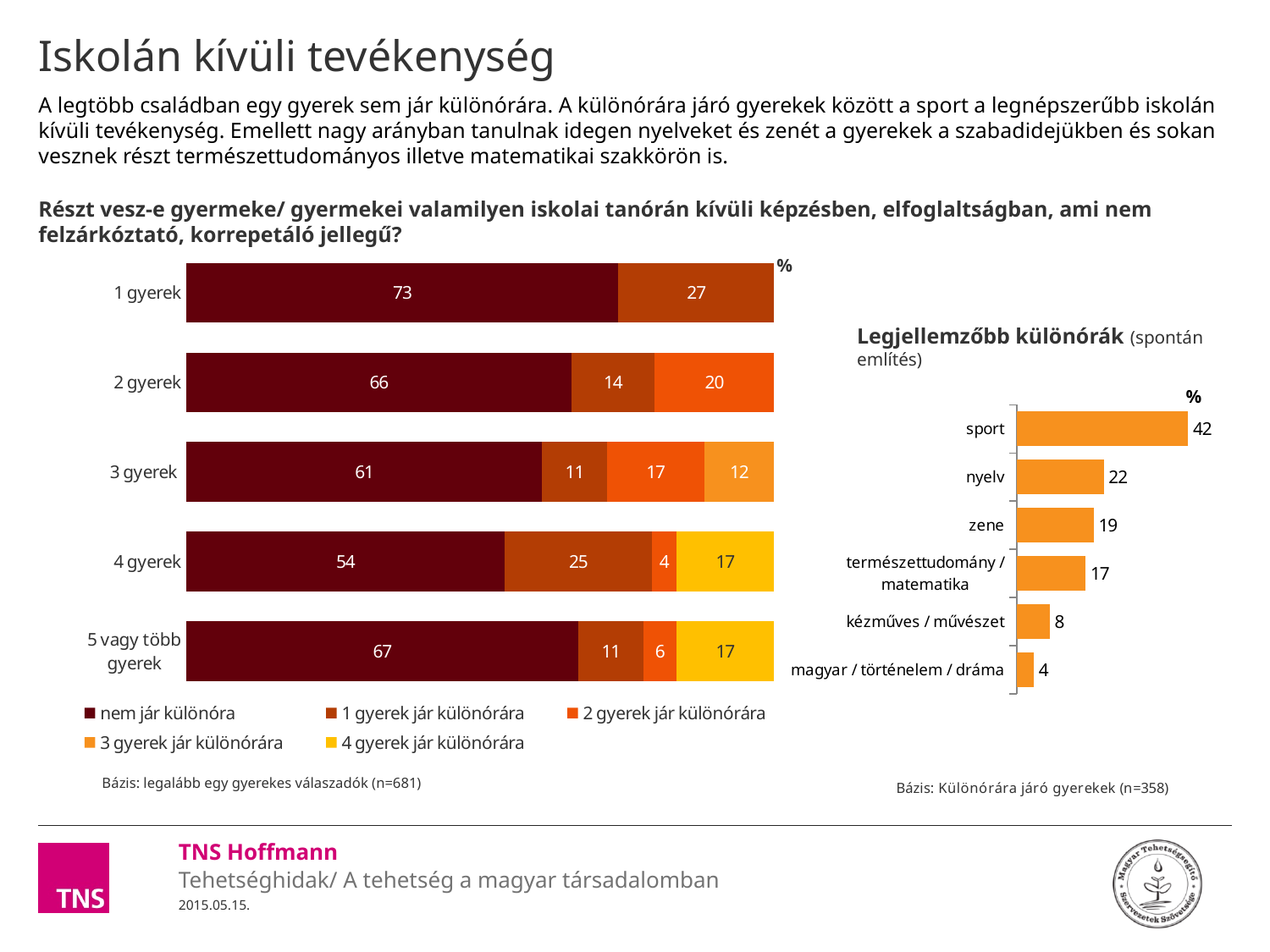
In the 'Legjellemzőbb különórák' chart, what is the difference between the values for nyelv and zene? 3 In the stacked bar chart on the left, which category has the highest value for 'nem jár különóra'? 1 gyerek In the stacked bar chart on the left, how many series does the legend list? 5 In the stacked bar chart on the left, what is the value of '1 gyerek jár különórára' for 2 gyerek? 14 In the 'Legjellemzőbb különórák' chart, how many categories are shown? 6 In the stacked bar chart on the left, what is the value of 'nem jár különóra' for 4 gyerek? 54 In the stacked bar chart on the left, what is the total of the bar for 3 gyerek? 101 In the stacked bar chart on the left, which is larger: the '2 gyerek jár különórára' value for 3 gyerek or for 4 gyerek? 3 gyerek In the 'Legjellemzőbb különórák' chart, do the values rise or fall from top to bottom? fall In the 'Legjellemzőbb különórák' chart, what is the value for sport? 42 What kind of chart is the 'Legjellemzőbb különórák' chart? bar chart In the 'Legjellemzőbb különórák' chart, which category has the lowest value? magyar / történelem / dráma